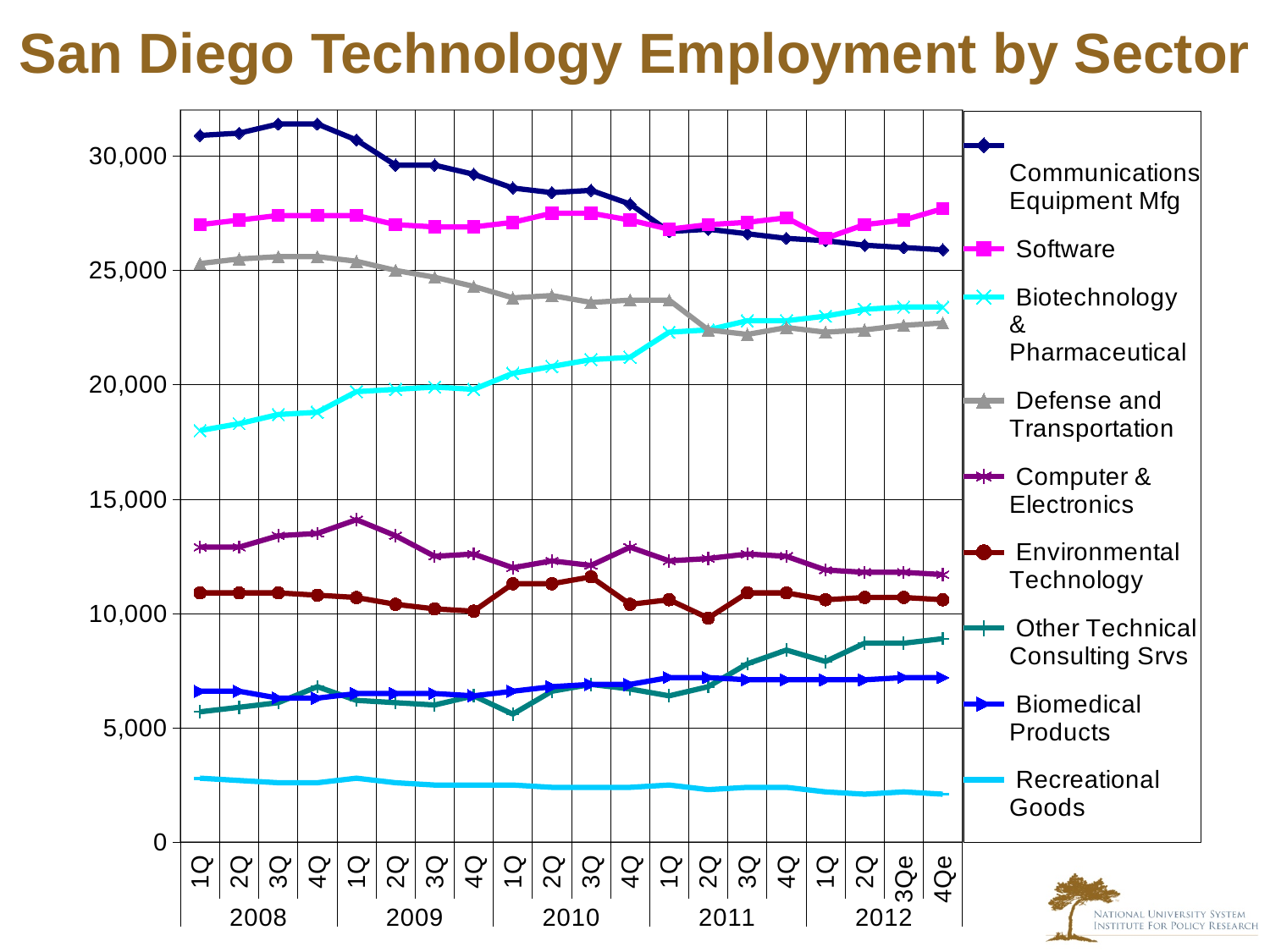
In 4Qe 2012, which is larger: Software or Communications Equipment Mfg? Software Is the value for Defense and Transportation in 4Qe 2012 greater or less than 25,000? less Is the value for Recreational Goods in 1Q 2010 greater or less than 5,000? less Which sector has the highest employment in 1Q 2008? Communications Equipment Mfg What kind of chart is shown on the slide? line chart Which sector has the lowest employment across the whole period? Recreational Goods How many quarterly points are plotted along the x axis? 20 Does employment in Communications Equipment Mfg rise or fall from 2008 to 2012? fall How many series does the legend list? 9 Does employment in Biotechnology & Pharmaceutical rise or fall from 2008 to 2012? rise Is the value for Communications Equipment Mfg in 1Q 2008 greater or less than 30,000? greater Which sector is represented by the grey line with triangle markers? Defense and Transportation